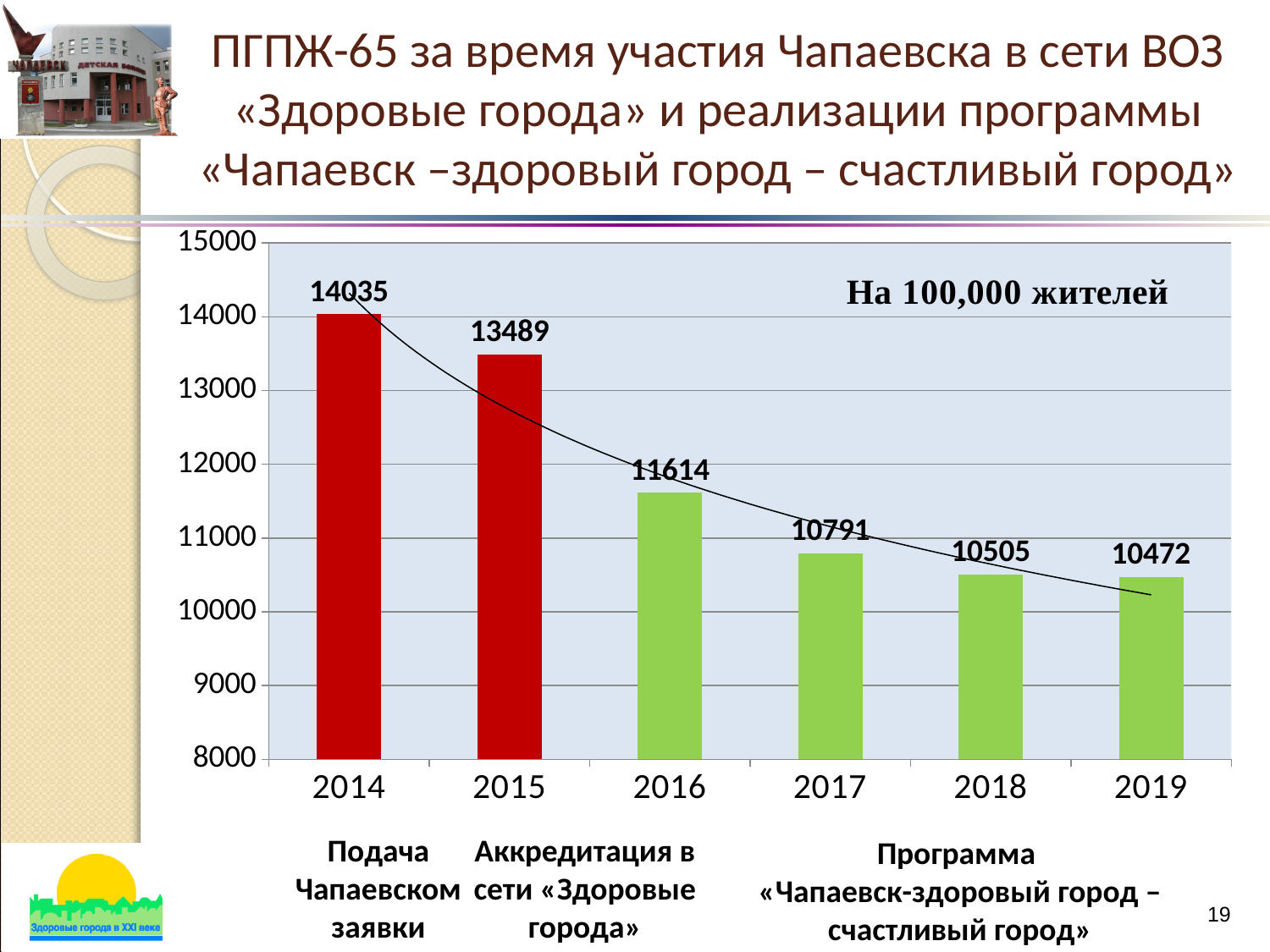
What is the difference between the values for 2014 and 2015? 546 What is the value for 2017? 10791 How many years are shown on the x axis? 6 What kind of chart is shown on the slide? bar chart Do the values rise or fall from 2014 to 2019? fall What is the difference between the values for 2016 and 2017? 823 Is the value for 2018 greater or less than 11000? less What is the value for 2019? 10472 Which year has the lowest value? 2019 What is the value for 2014? 14035 Which is larger, the value for 2015 or the value for 2016? 2015 Which year has the highest value? 2014